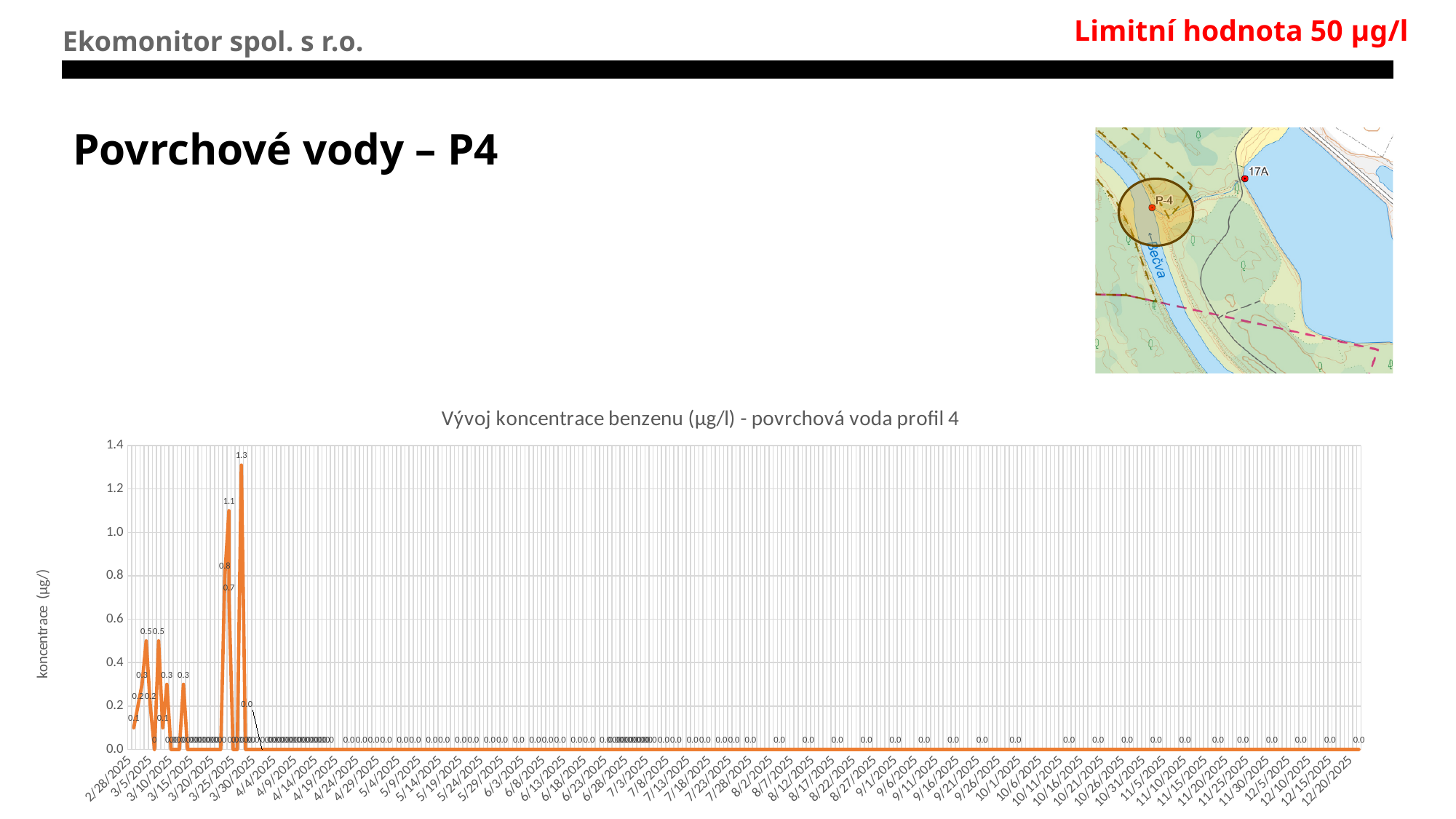
Is the peak value on the chart greater or less than 1.2? greater What is the second highest value labeled on the chart? 1.1 What kind of chart is shown on the slide? line chart What is the lowest value labeled on the chart? 0.0 What is the difference between the two highest labeled values, 1.3 and 1.1? 0.2 What limit value (Limitní hodnota) is stated in red at the top of the slide? 50 µg/l After the peak at the end of March 2025, do the values rise or fall over the rest of the year? fall What is the title of the chart? Vývoj koncentrace benzenu (µg/l) - povrchová voda profil 4 What is the highest tick value shown on the y axis? 1.4 Which is larger, the value labeled 0.8 or the value labeled 1.3? 1.3 What is the highest benzene concentration value labeled on the chart? 1.3 Is the value for 12/20/2025 greater or less than 0.2? less